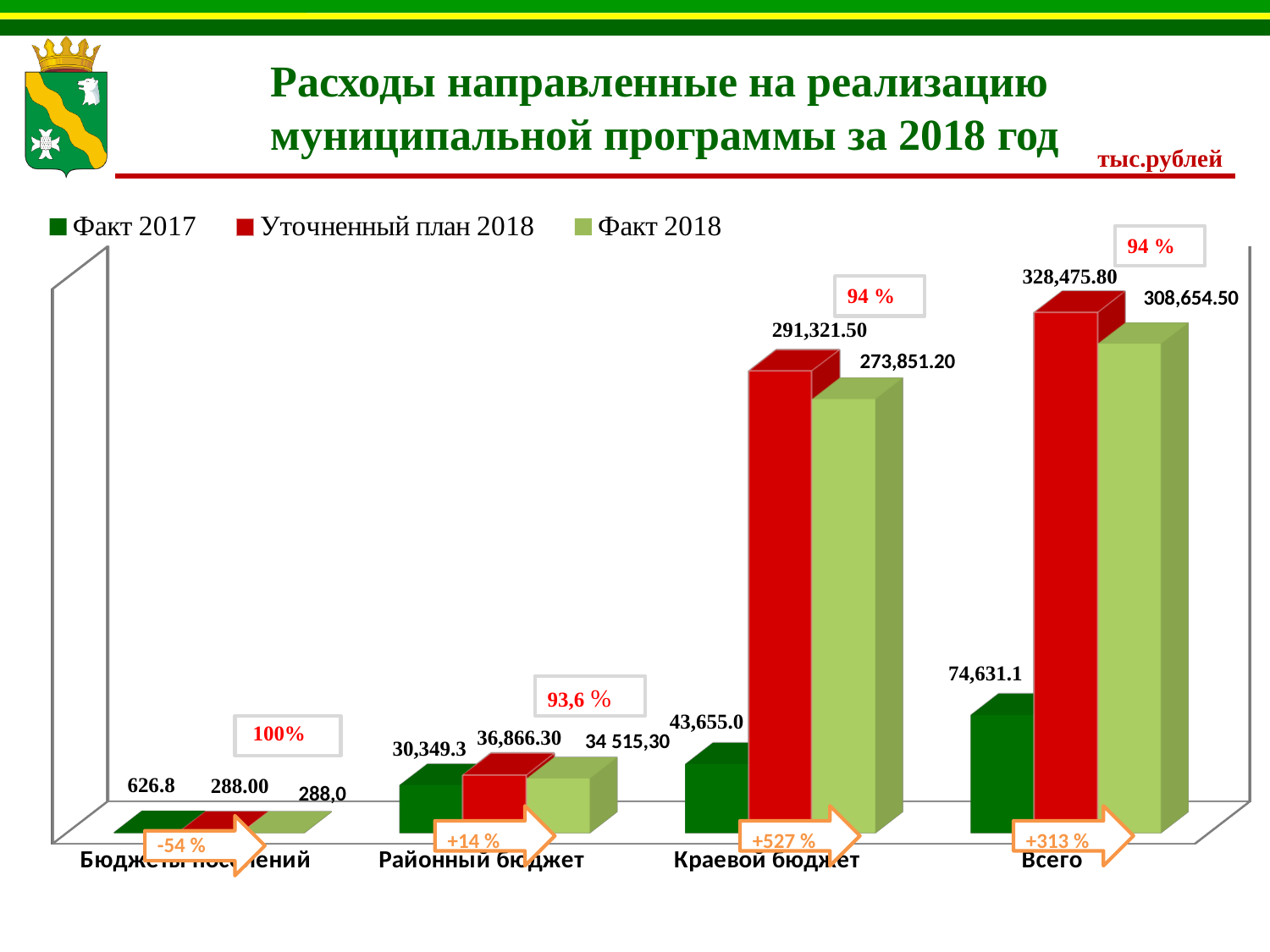
What type of chart is shown on the slide? Bar chart What is the value of Факт 2018 for Всего? 308,654.50 What percentage is shown in the box above the Всего bars? 94 % Which category has the highest value for Факт 2018? Всего How many series does the legend list? 3 What is the value of Факт 2017 for Бюджеты поселений? 626.8 What is the value of Уточненный план 2018 for Краевой бюджет? 291,321.50 Which category has the lowest value for Уточненный план 2018? Бюджеты поселений For Краевой бюджет, which is larger: Уточненный план 2018 or Факт 2018? Уточненный план 2018 What is the value of Факт 2017 for Районный бюджет? 30,349.3 What is the difference between Уточненный план 2018 and Факт 2018 for Всего? 19,821.30 How many categories are shown on the x axis? 4